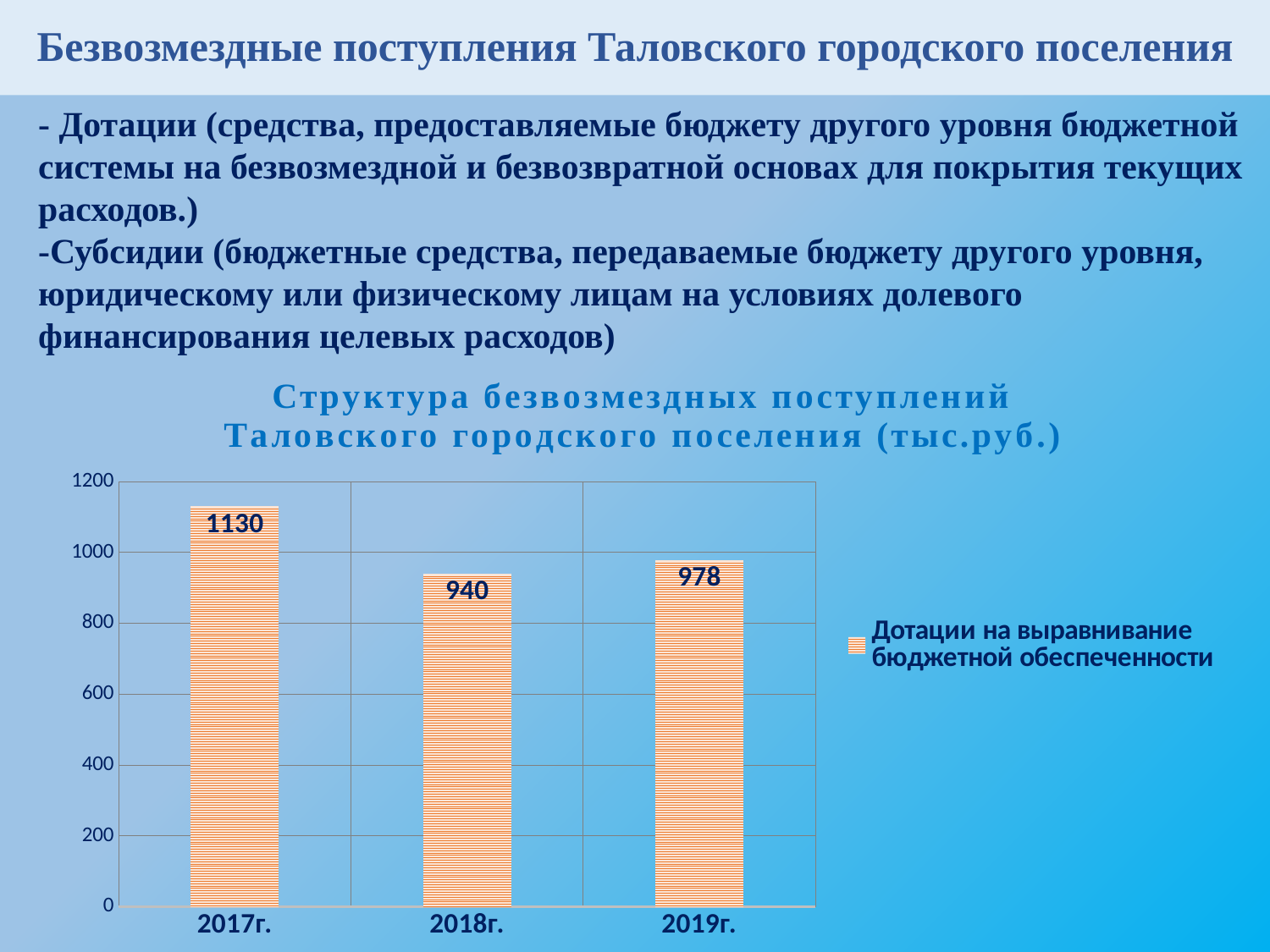
What is the value for 2018г.? 940 How many years are shown on the x axis? 3 What is the difference between the values for 2017г. and 2018г.? 190 Which year has the lowest value? 2018г. What is the value for 2019г.? 978 What is the value for 2017г.? 1130 What series does the legend list? Дотации на выравнивание бюджетной обеспеченности Which is larger, the value for 2017г. or the value for 2019г.? 2017г. What is the difference between the values for 2019г. and 2018г.? 38 Is the value for 2018г. greater or less than 1000? less What kind of chart is shown on the slide? bar chart Which year has the highest value? 2017г.